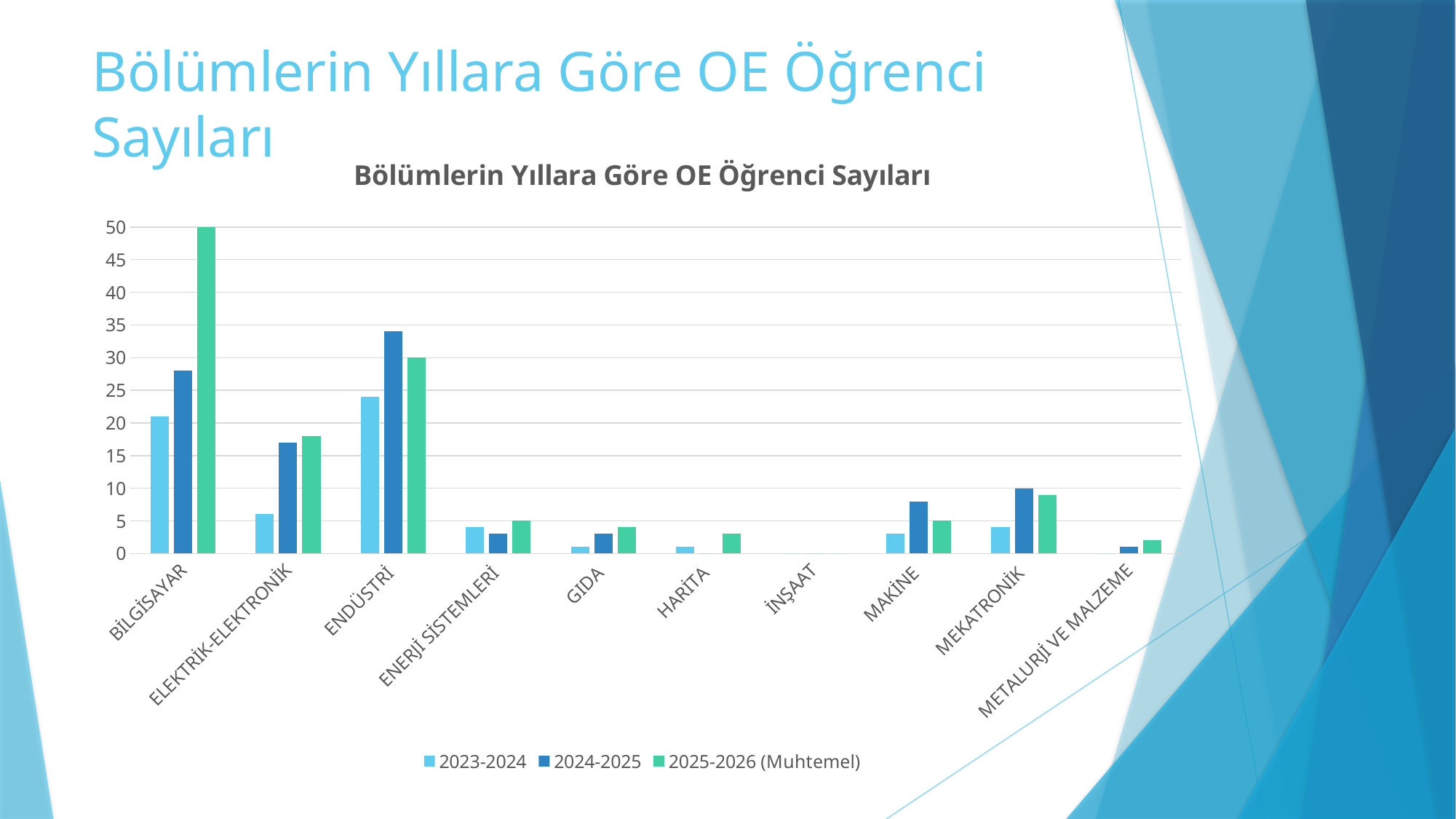
How many departments (categories) are shown on the x axis? 10 Which department has the tallest bar in the chart? BİLGİSAYAR Is the 2023-2024 value for ELEKTRİK-ELEKTRONİK greater or less than 10? less What is the 2025-2026 (Muhtemel) value for BİLGİSAYAR? 50 For ENDÜSTRİ, which is larger: the 2024-2025 value or the 2025-2026 (Muhtemel) value? 2024-2025 What is the 2025-2026 (Muhtemel) value for ENDÜSTRİ? 30 How many series does the legend list? 3 Is the 2024-2025 value for BİLGİSAYAR greater or less than 25? greater Do the values for BİLGİSAYAR rise or fall from 2023-2024 to 2025-2026 (Muhtemel)? rise What is the 2024-2025 value for MEKATRONİK? 10 What kind of chart is shown on the slide? bar chart What is the title of the chart? Bölümlerin Yıllara Göre OE Öğrenci Sayıları